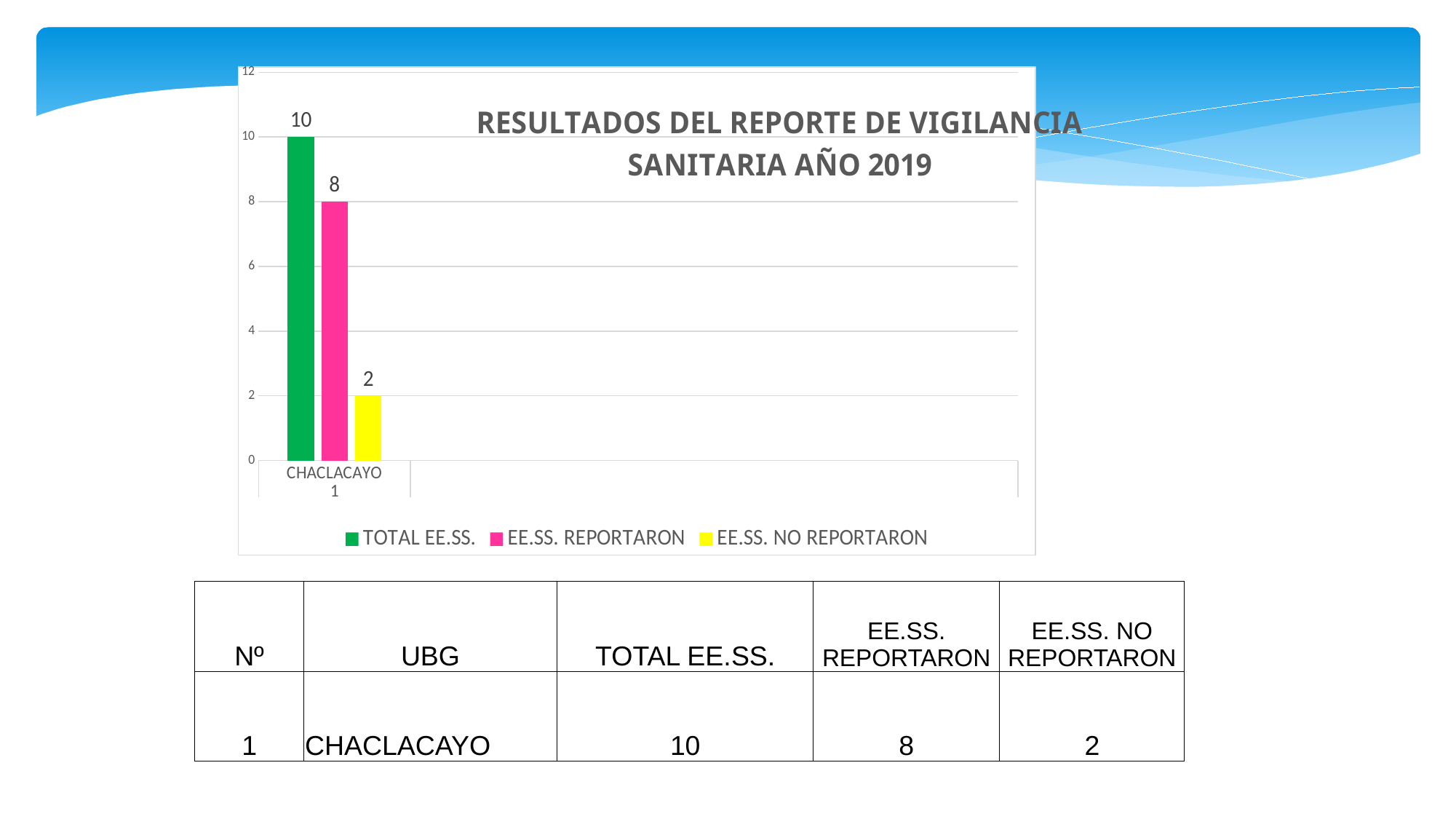
How many categories are shown on the x axis? 1 How many series does the legend list? 3 Which series has the highest value for CHACLACAYO? TOTAL EE.SS. What kind of chart is shown on the slide? Bar chart Which series has the lowest value for CHACLACAYO? EE.SS. NO REPORTARON What is the value of EE.SS. REPORTARON for CHACLACAYO? 8 What is the difference between EE.SS. REPORTARON and EE.SS. NO REPORTARON for CHACLACAYO? 6 What is the title of the chart? RESULTADOS DEL REPORTE DE VIGILANCIA SANITARIA AÑO 2019 What is the difference between TOTAL EE.SS. and EE.SS. REPORTARON for CHACLACAYO? 2 What is the value of TOTAL EE.SS. for CHACLACAYO? 10 What is the value of EE.SS. NO REPORTARON for CHACLACAYO? 2 Which is larger for CHACLACAYO, EE.SS. REPORTARON or EE.SS. NO REPORTARON? EE.SS. REPORTARON